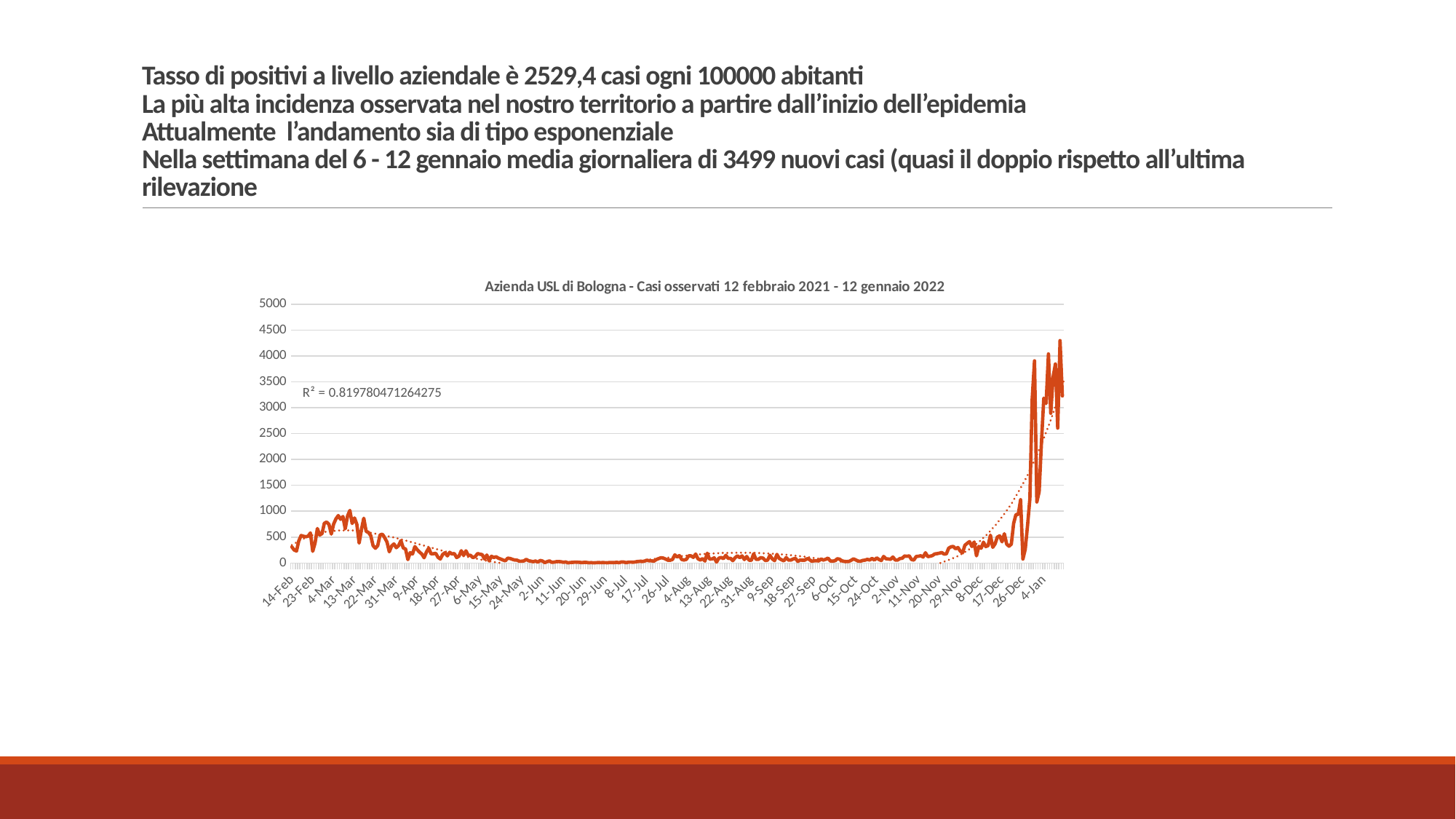
What kind of chart is shown on the slide? line chart Is the value around 20-Jun greater or less than 500? less Do the values rise or fall between 13-Mar and 20-Jun? fall Is the highest value reached around 4-Jan greater or less than 4000? greater Which is larger, the peak in March or the peak in January? the peak in January What is the title of the chart? Azienda USL di Bologna - Casi osservati 12 febbraio 2021 - 12 gennaio 2022 Overall, do the values rise or fall from 14-Feb to the end of the series in January? rise Is the value around 4-Mar greater or less than 500? greater What R² value is printed on the chart? R² = 0.819780471264275 In which month does the line reach its highest values? January Which is larger, the value around 4-Mar or the value around 20-Jun? the value around 4-Mar